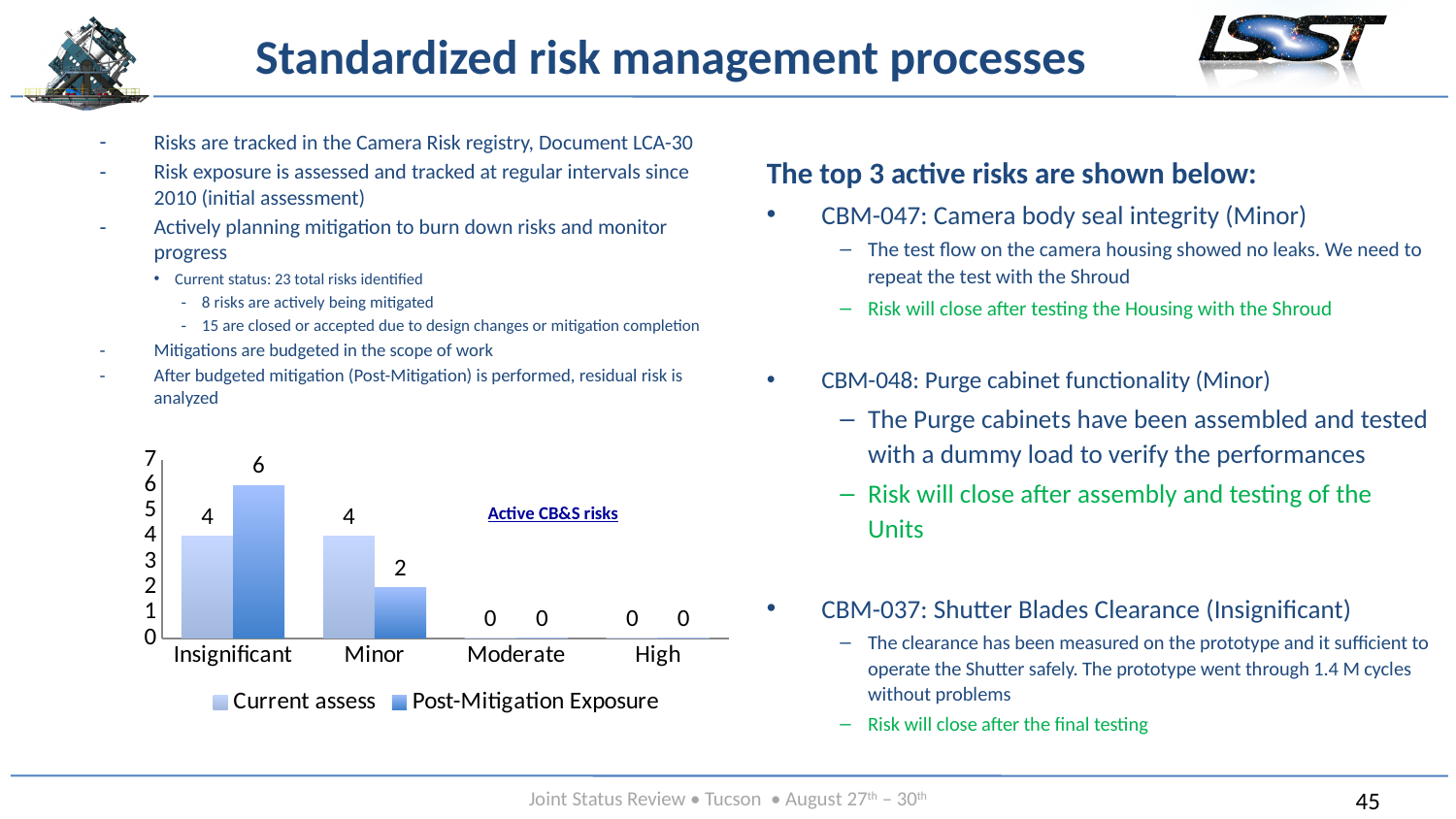
How many categories are shown on the x axis of the chart? 4 What is the Current assess value for the Moderate category? 0 For the Insignificant category, which is larger: Current assess or Post-Mitigation Exposure? Post-Mitigation Exposure What is the Post-Mitigation Exposure value for the Minor category? 2 What is the Current assess value for the Insignificant category? 4 How many series does the chart legend list? 2 What is the title of the chart? Active CB&S risks What is the Post-Mitigation Exposure value for the Insignificant category? 6 What type of chart is shown on the slide? bar chart What are the two series names listed in the chart legend? Current assess and Post-Mitigation Exposure What is the difference between the Current assess and Post-Mitigation Exposure values for the Minor category? 2 Which category has the highest Post-Mitigation Exposure value? Insignificant